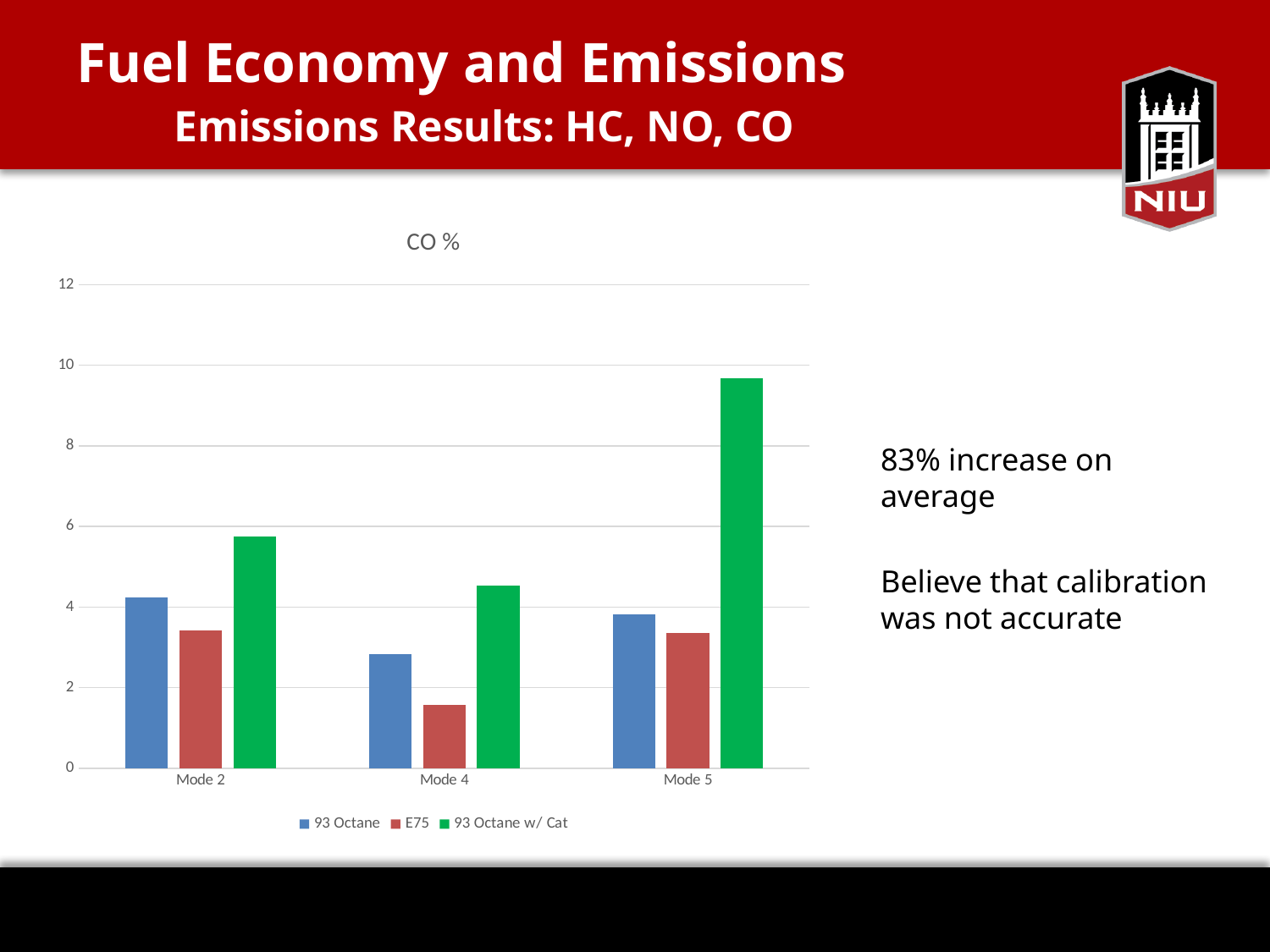
How many series does the legend list? 3 Which is larger in Mode 2: the value for 93 Octane or the value for E75? 93 Octane Is the value for E75 in Mode 4 greater or less than 2? less Which series has the highest value in Mode 5? 93 Octane w/ Cat What type of chart is shown on the slide? bar chart Is the value for 93 Octane w/ Cat in Mode 5 greater or less than 8? greater What is the title of the chart? CO % Is the value for 93 Octane in Mode 2 greater or less than 4? greater Which series is shown in green in the legend? 93 Octane w/ Cat How many modes (categories) are shown on the x axis? 3 In which mode does 93 Octane w/ Cat reach its highest value? Mode 5 Which series has the lowest value in Mode 4? E75